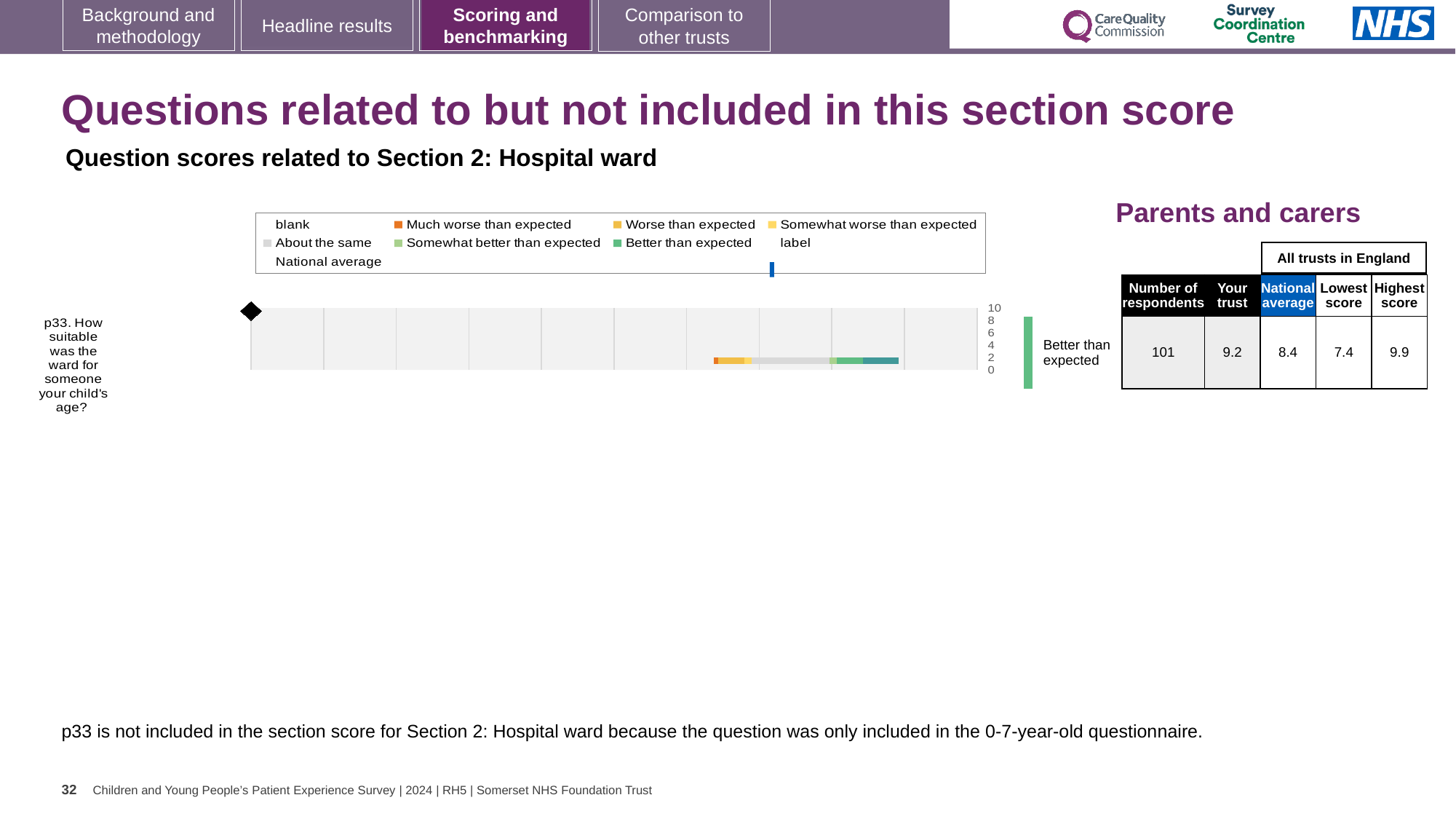
In the table next to the chart, how many respondents answered p33? 101 What rating label is shown to the right of the chart for p33? Better than expected In the table next to the chart, what is the Lowest score among all trusts in England for p33? 7.4 What kind of chart is shown on the slide? bar chart What is the highest value shown on the chart's axis? 10 How many questions (categories) are plotted in the chart? 1 In the table next to the chart, what is the 'Your trust' score for p33? 9.2 What is the difference between the 'Your trust' score and the National average for p33? 0.8 Is the 'Your trust' score for p33 larger or smaller than the National average? larger Which question is plotted in the chart? p33. How suitable was the ward for someone your child's age? In the table next to the chart, what is the Highest score among all trusts in England for p33? 9.9 In the table next to the chart, what is the National average score for p33? 8.4